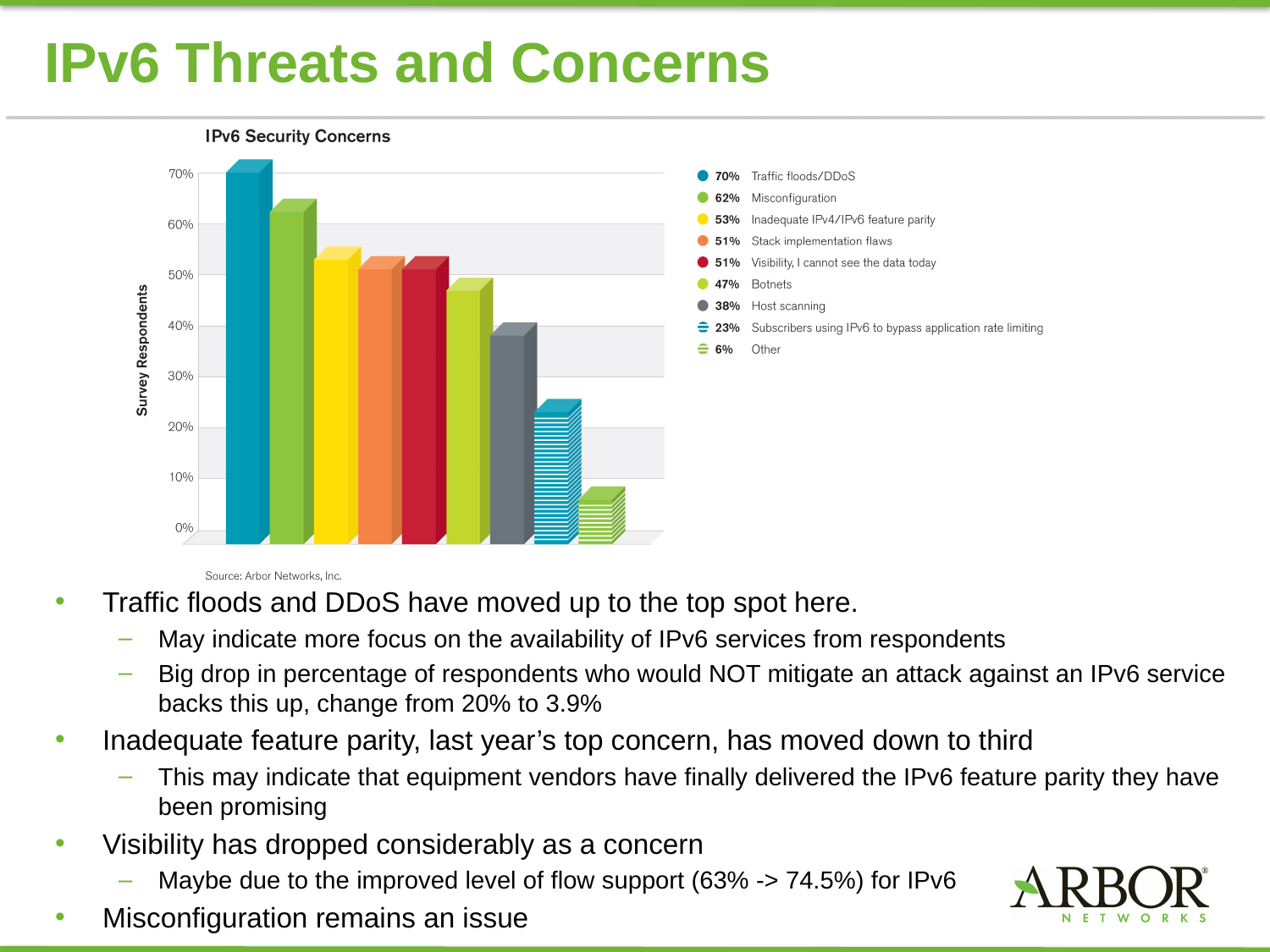
What is the label on the vertical axis of the IPv6 Security Concerns chart? Survey Respondents What percentage is shown for Host scanning? 38% What type of chart is used to show IPv6 Security Concerns? Bar chart What is the difference between the Botnets value and the Host scanning value? 9 Which has a higher percentage: Inadequate IPv4/IPv6 feature parity or Botnets? Inadequate IPv4/IPv6 feature parity What is the difference in percentage points between Traffic floods/DDoS and Misconfiguration? 8 What percentage of respondents cited Subscribers using IPv6 to bypass application rate limiting? 23% What value is shown for Misconfiguration in the IPv6 Security Concerns chart? 62% Which IPv6 security concern has the highest percentage of respondents? Traffic floods/DDoS How many categories are plotted in the IPv6 Security Concerns chart? 9 Which category has the lowest value in the IPv6 Security Concerns chart? Other What percentage of survey respondents cited Traffic floods/DDoS as an IPv6 security concern? 70%